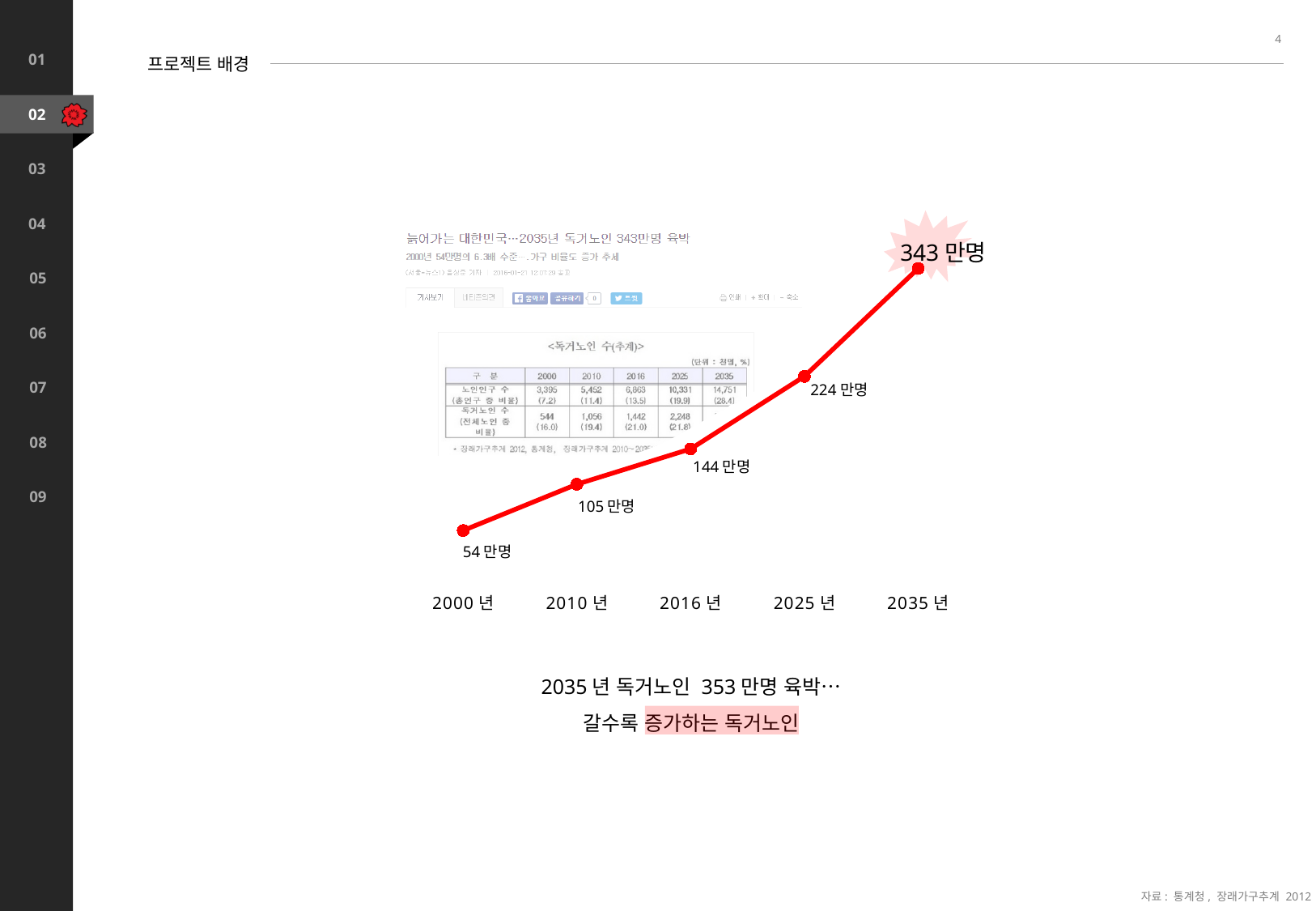
What is the value for 2000 년? 54 만명 What is the value for 2035 년? 343 만명 Which year has the lowest value? 2000 년 What is the difference between the values for 2035 년 and 2000 년? 289 만명 What kind of chart is shown on the slide? line chart What is the difference between the values for 2025 년 and 2016 년? 80 만명 What is the value for 2016 년? 144 만명 How many data points are plotted on the chart? 5 Which is larger, the value for 2010 년 or the value for 2016 년? 2016 년 What is the value for 2025 년? 224 만명 Which year has the highest value? 2035 년 Do the values rise or fall from 2000 년 to 2035 년? rise